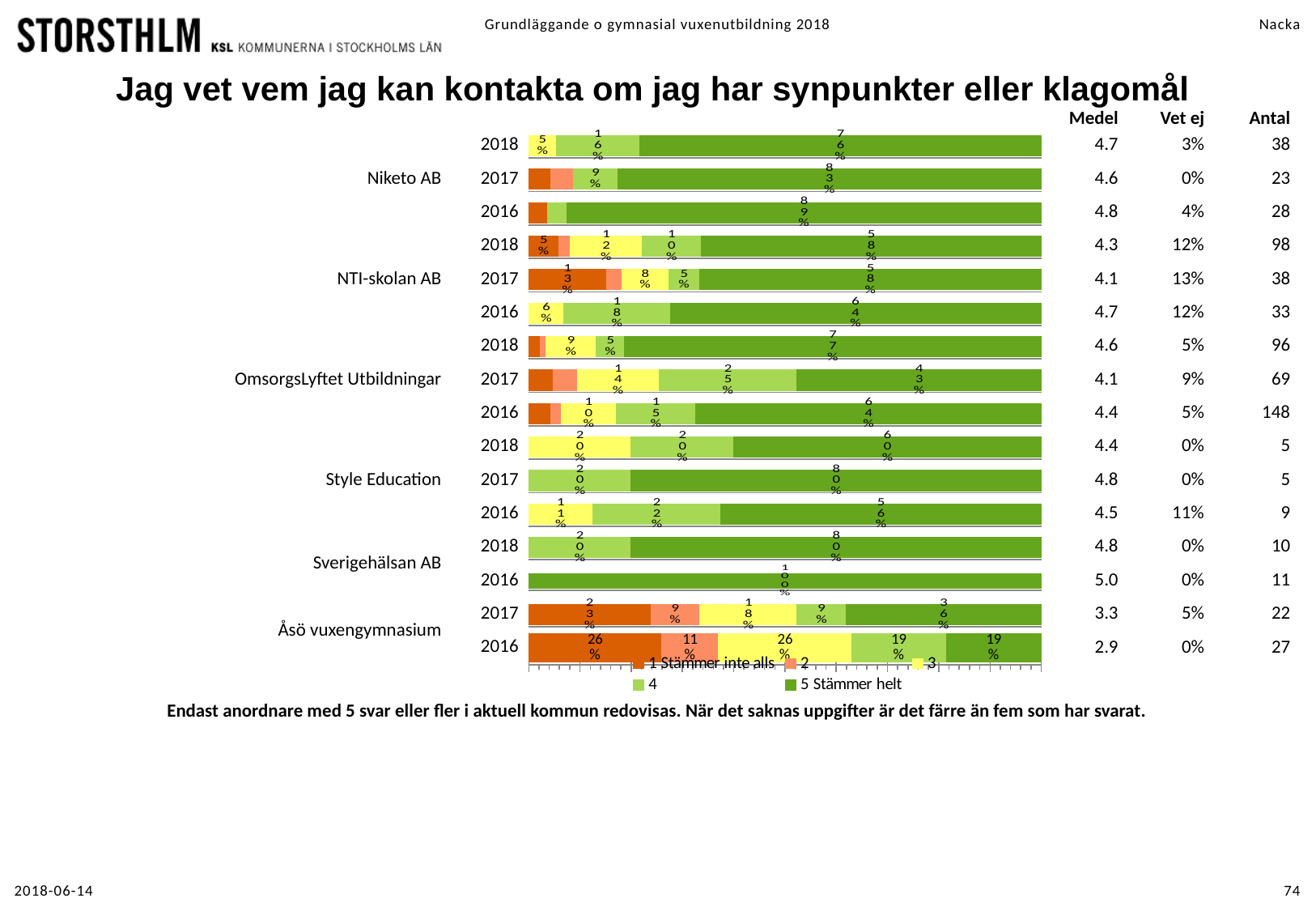
What is the difference between the '5 Stämmer helt' segment for Åsö vuxengymnasium in 2017 and in 2016? 17% What is the value of the '3' segment for NTI-skolan AB in 2018? 12% Which bar has the largest '1 Stämmer inte alls' segment? Åsö vuxengymnasium 2016 What is the value of the '5 Stämmer helt' segment for OmsorgsLyftet Utbildningar in 2017? 43% Which is larger: the '5 Stämmer helt' segment for NTI-skolan AB in 2018 or for Niketo AB in 2016? Niketo AB in 2016 What is the value of the '4' segment for Style Education in 2017? 20% What is the value of the '1 Stämmer inte alls' segment for Åsö vuxengymnasium in 2016? 26% What is the value of the '5 Stämmer helt' segment for Niketo AB in 2018? 76% How many series does the legend list? 5 What is the value of the '5 Stämmer helt' segment for Sverigehälsan AB in 2016? 100% What is the label of the first legend entry? 1 Stämmer inte alls What kind of chart is shown on the slide? Stacked bar chart